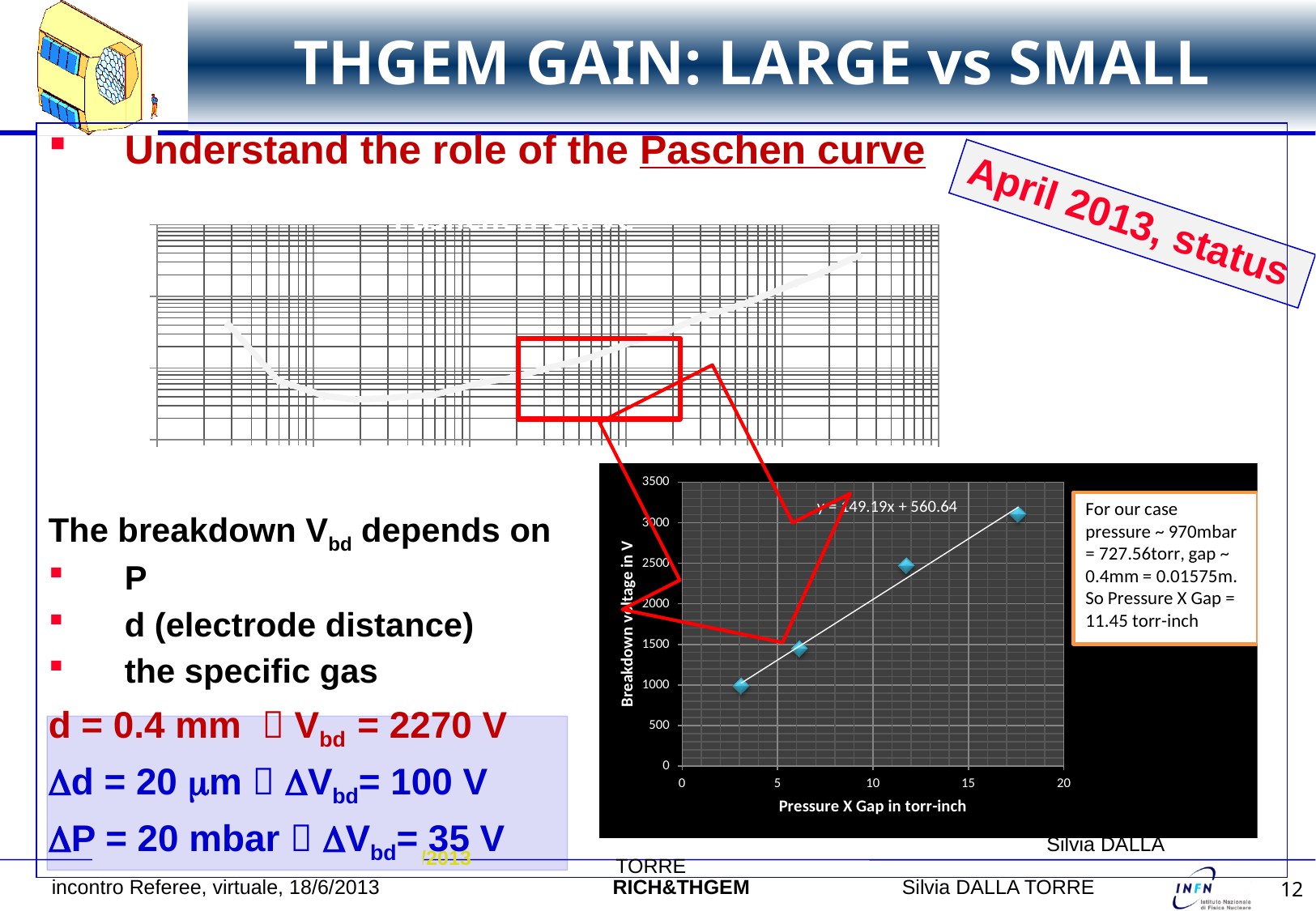
In the bottom-right chart, which data point has the lowest breakdown voltage? the leftmost point In the bottom-right chart, is the breakdown voltage of the leftmost data point greater or less than 1500? less What kind of chart is the chart at the bottom right of the slide? scatter chart In the bottom-right chart, what is the title of the horizontal axis? Pressure X Gap in torr-inch In the bottom-right chart, which data point has the highest breakdown voltage: the leftmost or the rightmost? the rightmost In the bottom-right chart, is the breakdown voltage of the second data point from the left greater or less than 1000? greater In the bottom-right chart, is the breakdown voltage of the third data point from the left greater or less than 2000? greater What is the highest tick value shown on the vertical axis of the bottom-right chart? 3500 In the bottom-right chart, what is the title of the vertical axis? Breakdown voltage in V In the bottom-right chart, does the breakdown voltage rise or fall as Pressure X Gap increases? rise How many data points are plotted in the bottom-right chart? 4